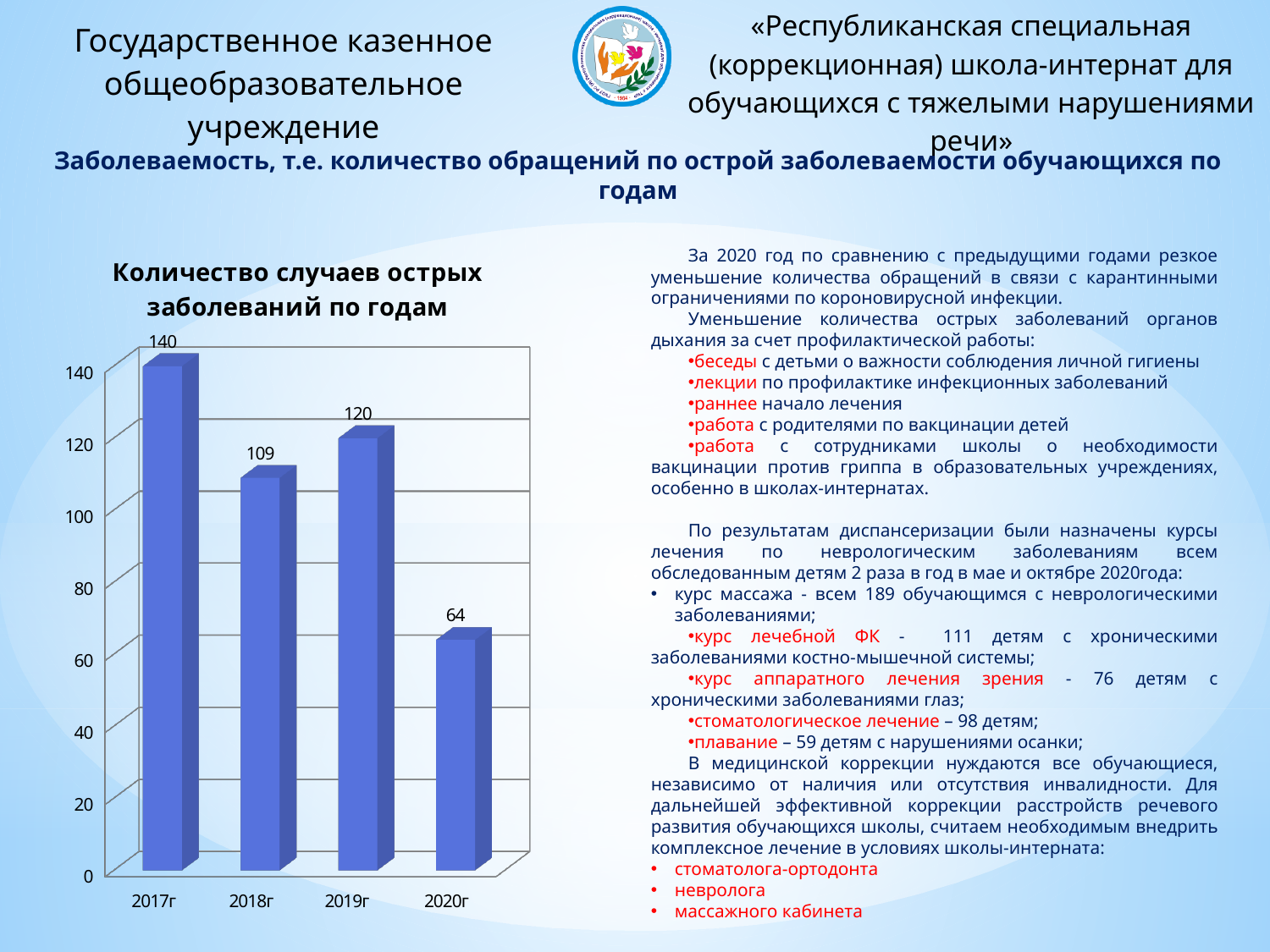
Which year has the highest number of cases? 2017г What is the difference between the values for 2017г and 2020г? 76 Which is larger, the value for 2018г or the value for 2019г? 2019г What is the value for 2017г in the chart? 140 What kind of chart is shown on the slide? bar chart Which year has the lowest number of cases? 2020г What is the title of the chart? Количество случаев острых заболеваний по годам What is the value for 2018г in the chart? 109 What is the difference between the values for 2019г and 2018г? 11 What is the value for 2020г in the chart? 64 How many years are shown on the x axis of the chart? 4 What is the value for 2019г in the chart? 120